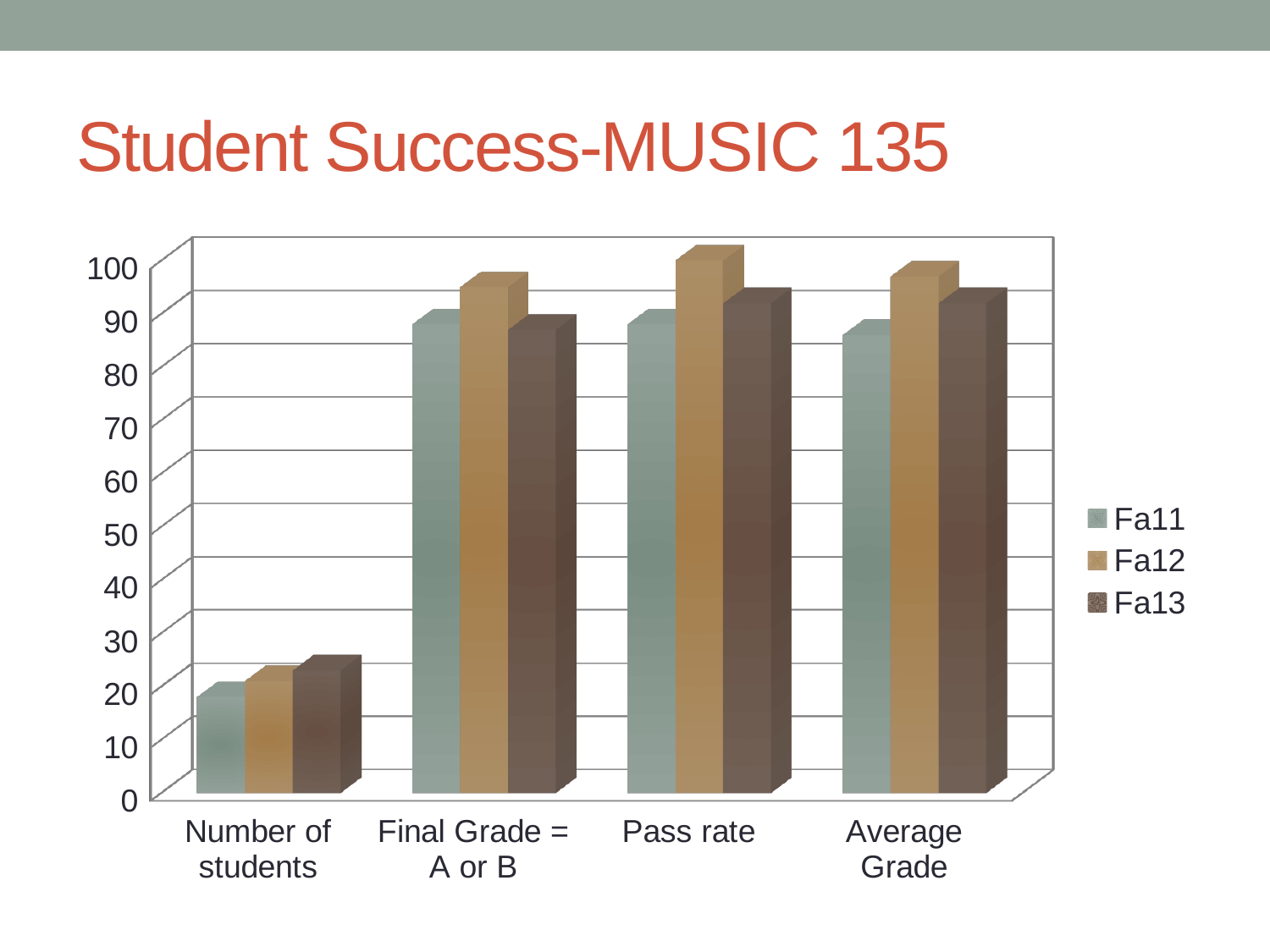
Which series has the highest Pass rate? Fa12 Which series has the lowest Average Grade? Fa11 Is the Average Grade for Fa11 greater or less than 80? greater For Final Grade = A or B, which is larger: Fa12 or Fa13? Fa12 How many series does the legend list? 3 What is the title of the chart on the slide? Student Success-MUSIC 135 Is the Pass rate for Fa12 greater or less than 90? greater What type of chart is shown on the slide? Bar chart How many categories are shown along the x axis? 4 Which category has the lowest values across all series? Number of students For Pass rate, which is larger: Fa11 or Fa12? Fa12 Is the Number of students for Fa11 greater or less than 30? less